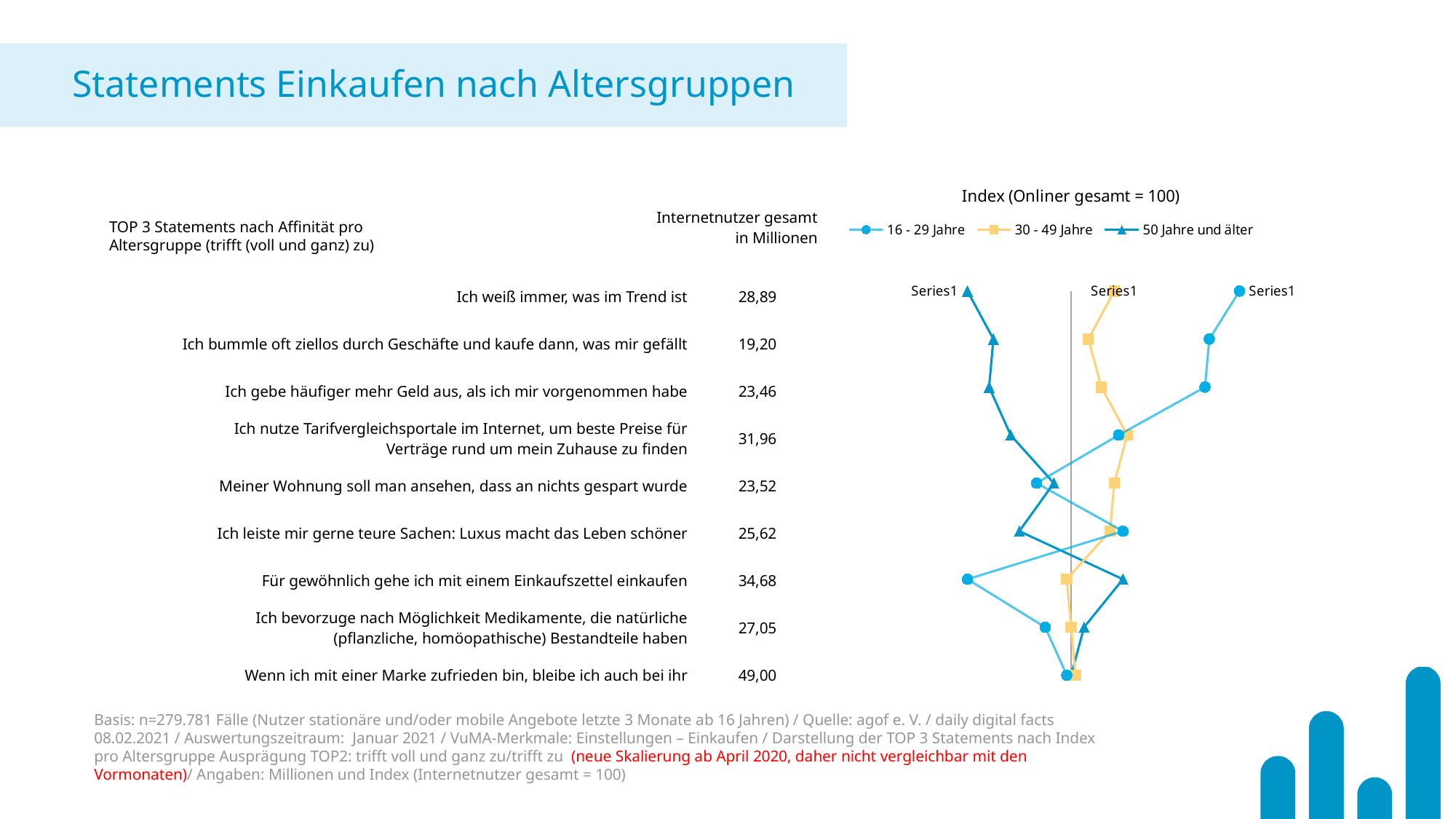
How many statements are plotted in the chart? 9 What is the value in millions (Internetnutzer gesamt) for "Ich weiß immer, was im Trend ist"? 28,89 What is the difference in millions between "Wenn ich mit einer Marke zufrieden bin, bleibe ich auch bei ihr" (49,00) and "Ich bummle oft ziellos durch Geschäfte und kaufe dann, was mir gefällt" (19,20)? 29,80 What kind of chart is shown on the slide? line chart Which has the larger value in millions: "Für gewöhnlich gehe ich mit einem Einkaufszettel einkaufen" or "Ich nutze Tarifvergleichsportale im Internet, um beste Preise für Verträge rund um mein Zuhause zu finden"? Für gewöhnlich gehe ich mit einem Einkaufszettel einkaufen What is the value in millions (Internetnutzer gesamt) for "Für gewöhnlich gehe ich mit einem Einkaufszettel einkaufen"? 34,68 Which age groups are listed in the chart legend? 16 - 29 Jahre, 30 - 49 Jahre, 50 Jahre und älter Which statement has the lowest value for Internetnutzer gesamt in Millionen? Ich bummle oft ziellos durch Geschäfte und kaufe dann, was mir gefällt For the statement "Ich weiß immer, was im Trend ist", which age group has the highest index value in the chart? 16 - 29 Jahre Which statement has the highest value for Internetnutzer gesamt in Millionen? Wenn ich mit einer Marke zufrieden bin, bleibe ich auch bei ihr How many series does the chart legend list? 3 What is the title above the chart legend? Index (Onliner gesamt = 100)